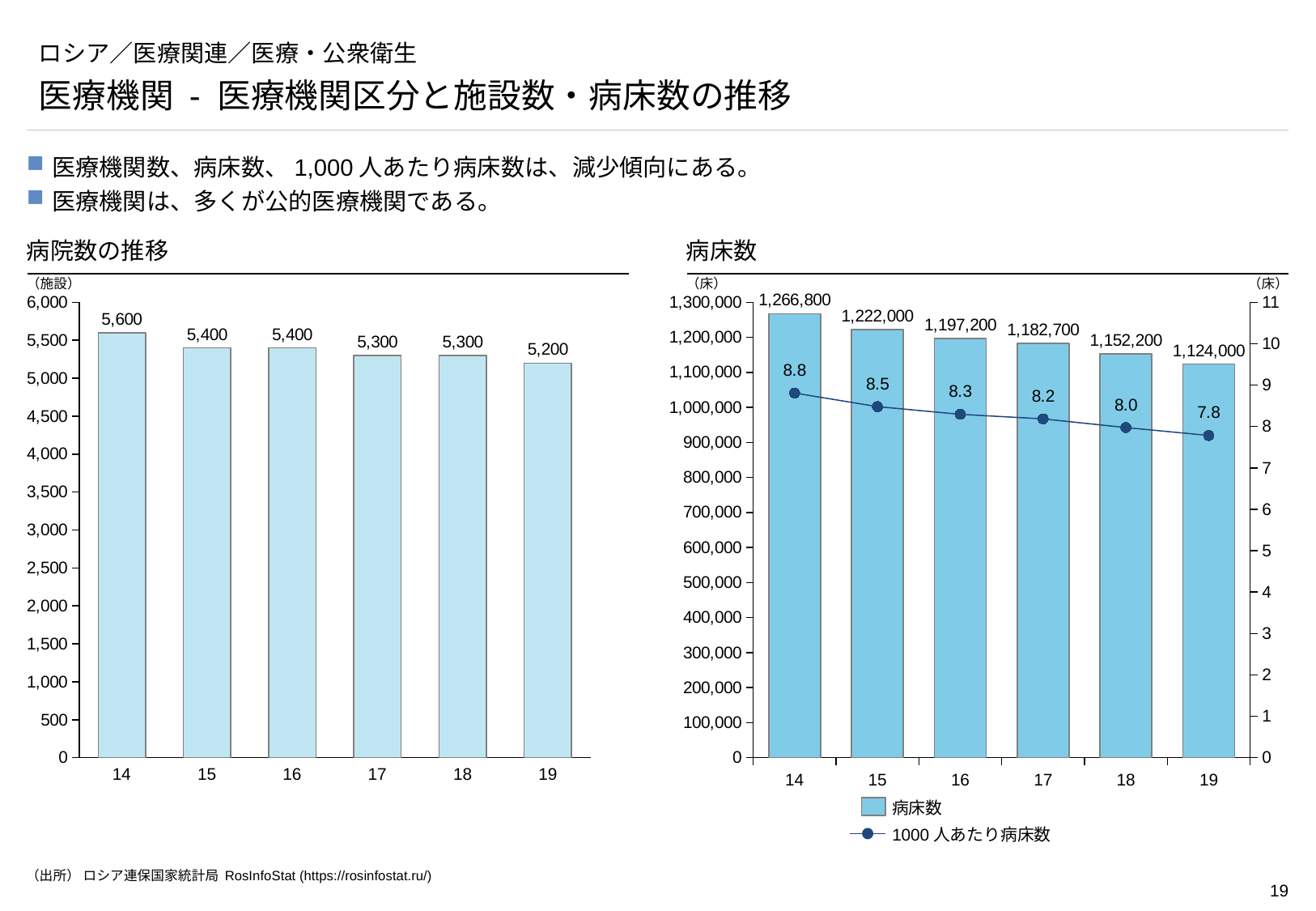
In the 病院数の推移 chart, how many bars are plotted? 6 In the 病院数の推移 chart, which year has the lowest value? 19 In the 病床数 chart, what is the 1000 人あたり病床数 value for 16? 8.3 In the 病床数 chart, which year has the highest 病床数? 14 In the 病床数 chart, what is the difference in 病床数 between 14 and 15? 44,800 In the 病院数の推移 chart, what is the difference between the values for 14 and 19? 400 In the 病院数の推移 chart, what is the value for 14? 5,600 In the 病床数 chart, how many series does the legend list? 2 In the 病床数 chart, is the 病床数 for 18 larger or smaller than for 19? larger In the 病床数 chart, what is the 病床数 value for 17? 1,182,700 In the 病院数の推移 chart, do the values rise or fall from 14 to 19? fall What kind of chart is the 病院数の推移 chart? bar chart